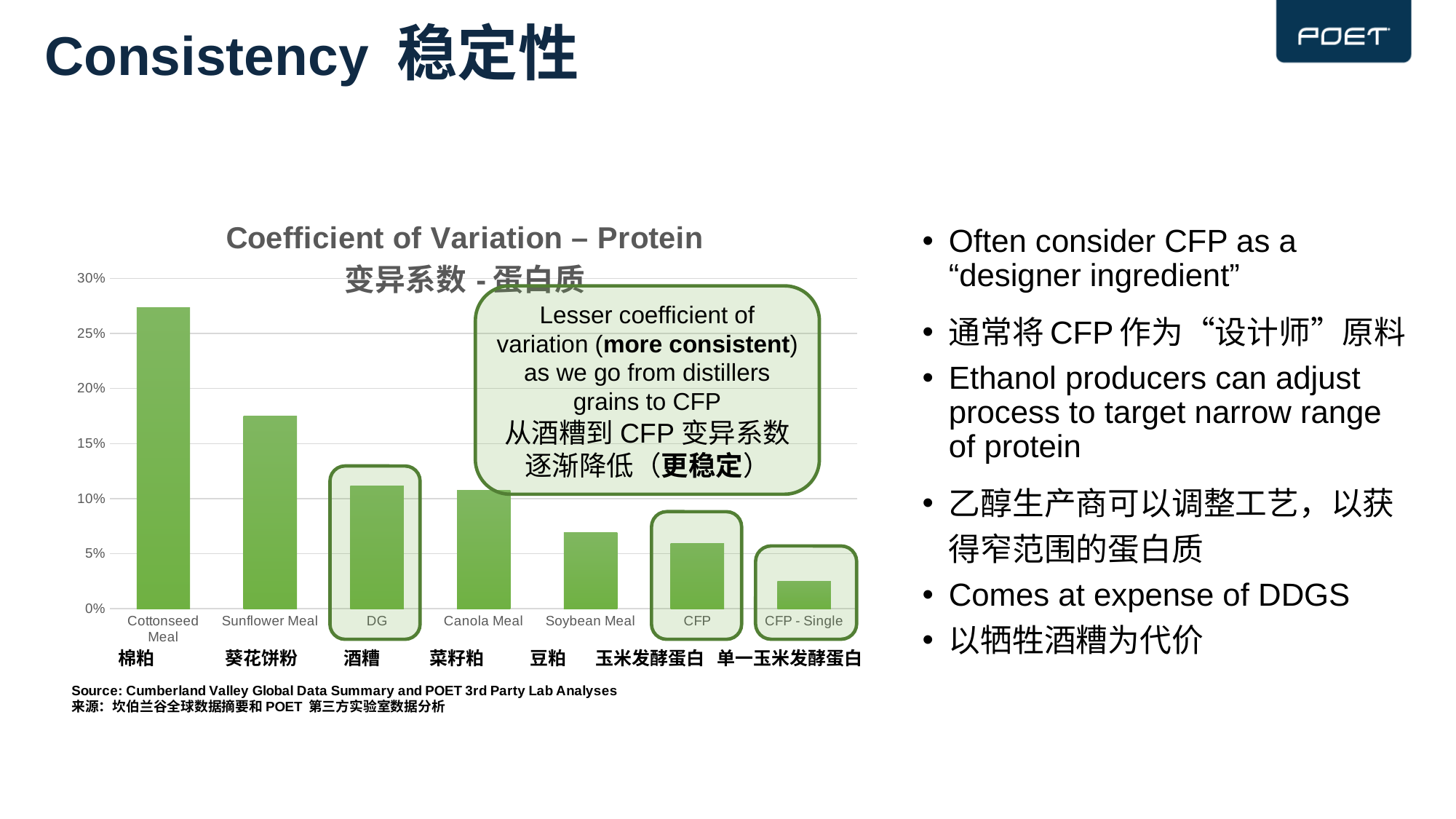
What is the title of the chart? Coefficient of Variation – Protein Is the value for Cottonseed Meal greater or less than 25%? greater Is the value for Sunflower Meal greater or less than 15%? greater Do the bar values rise or fall from left to right across the categories? fall Which is larger, the value for CFP or the value for CFP - Single? CFP Which category has the highest coefficient of variation? Cottonseed Meal Which is larger, the value for Sunflower Meal or the value for DG? Sunflower Meal Which category has the lowest coefficient of variation? CFP - Single How many categories are plotted in the chart? 7 Is the value for CFP - Single greater or less than 5%? less What kind of chart is shown on the slide? bar chart